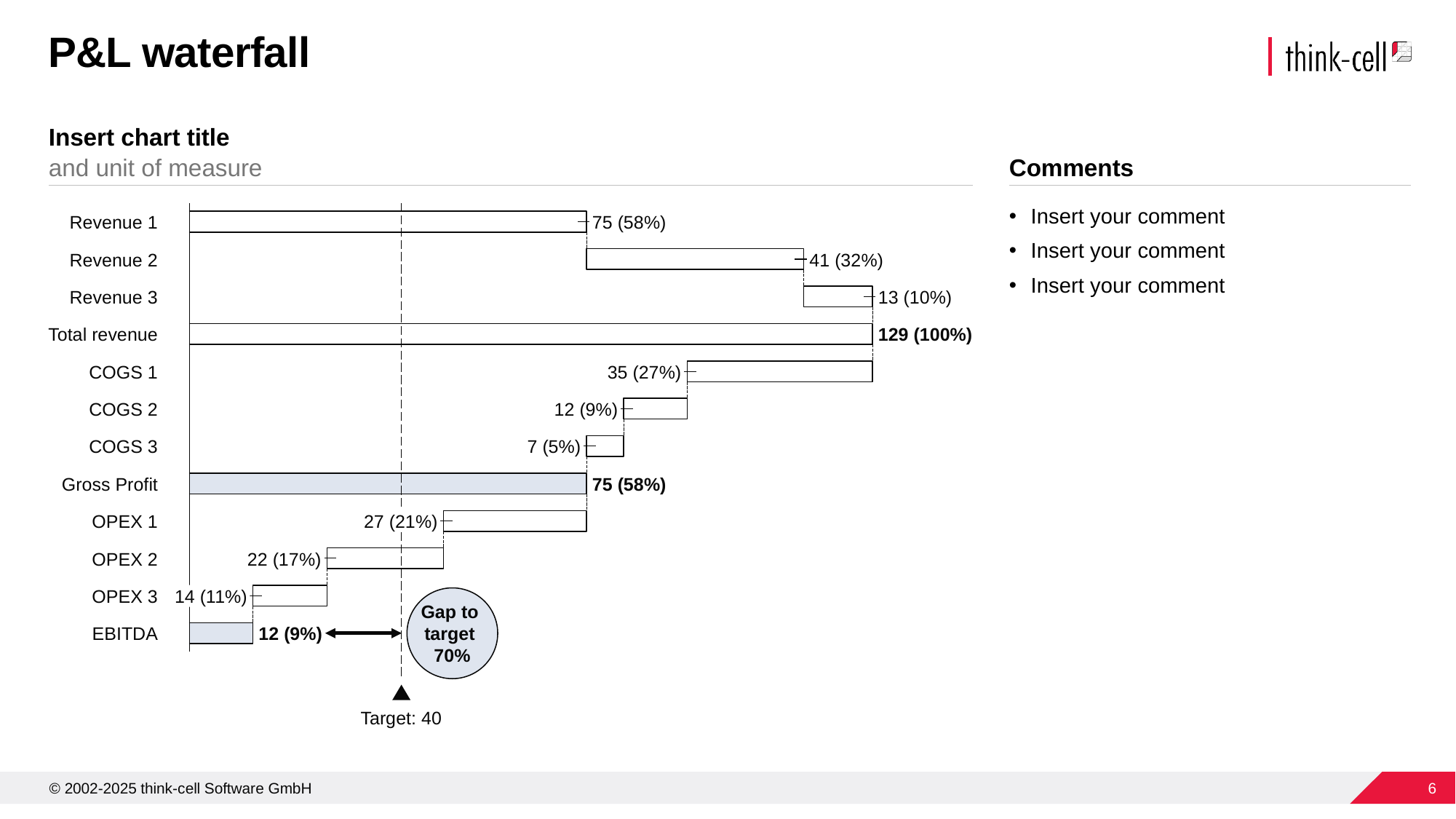
What is the data label shown for Total revenue? 129 (100%) What is the data label shown for EBITDA? 12 (9%) What target value is marked on the chart? Target: 40 Which is larger, the value for OPEX 1 or the value for OPEX 3? OPEX 1 What kind of chart is shown on the slide? Waterfall bar chart What is the difference between the Gross Profit value (75) and the EBITDA value (12)? 63 What is the data label shown for COGS 1? 35 (27%) What is the data label shown for OPEX 2? 22 (17%) Which of the three COGS items has the largest value? COGS 1 Which of the three revenue items (Revenue 1, Revenue 2, Revenue 3) has the smallest value? Revenue 3 What is the data label shown for Revenue 1? 75 (58%) How many categories are listed on the vertical axis of the chart? 12